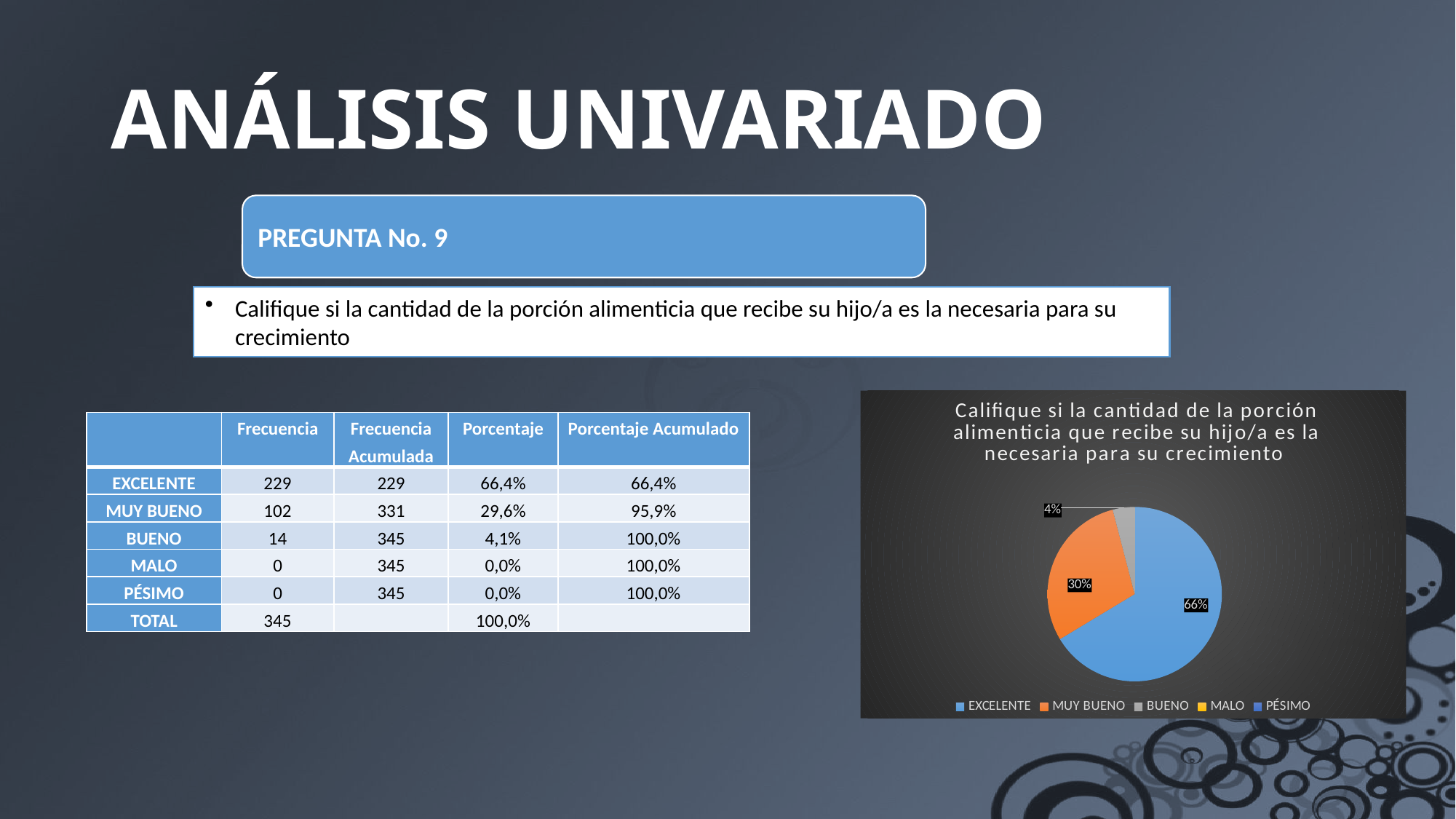
Which of the labelled slices in the pie chart is the smallest? BUENO In the pie chart, what share is labelled for BUENO? 4% How many categories does the legend of the pie chart list? 5 What kind of chart is shown on the slide? pie chart What is the difference in percentage points between the EXCELENTE and MUY BUENO slices in the pie chart? 36 What is the difference in percentage points between the MUY BUENO and BUENO slices in the pie chart? 26 In the pie chart, which slice is larger: EXCELENTE or MUY BUENO? EXCELENTE Which category has the largest slice in the pie chart? EXCELENTE What colour is the MUY BUENO slice in the pie chart? orange In the pie chart, what share is labelled for MUY BUENO? 30% In the pie chart, what share is labelled for EXCELENTE? 66% What colour is the EXCELENTE slice in the pie chart? blue